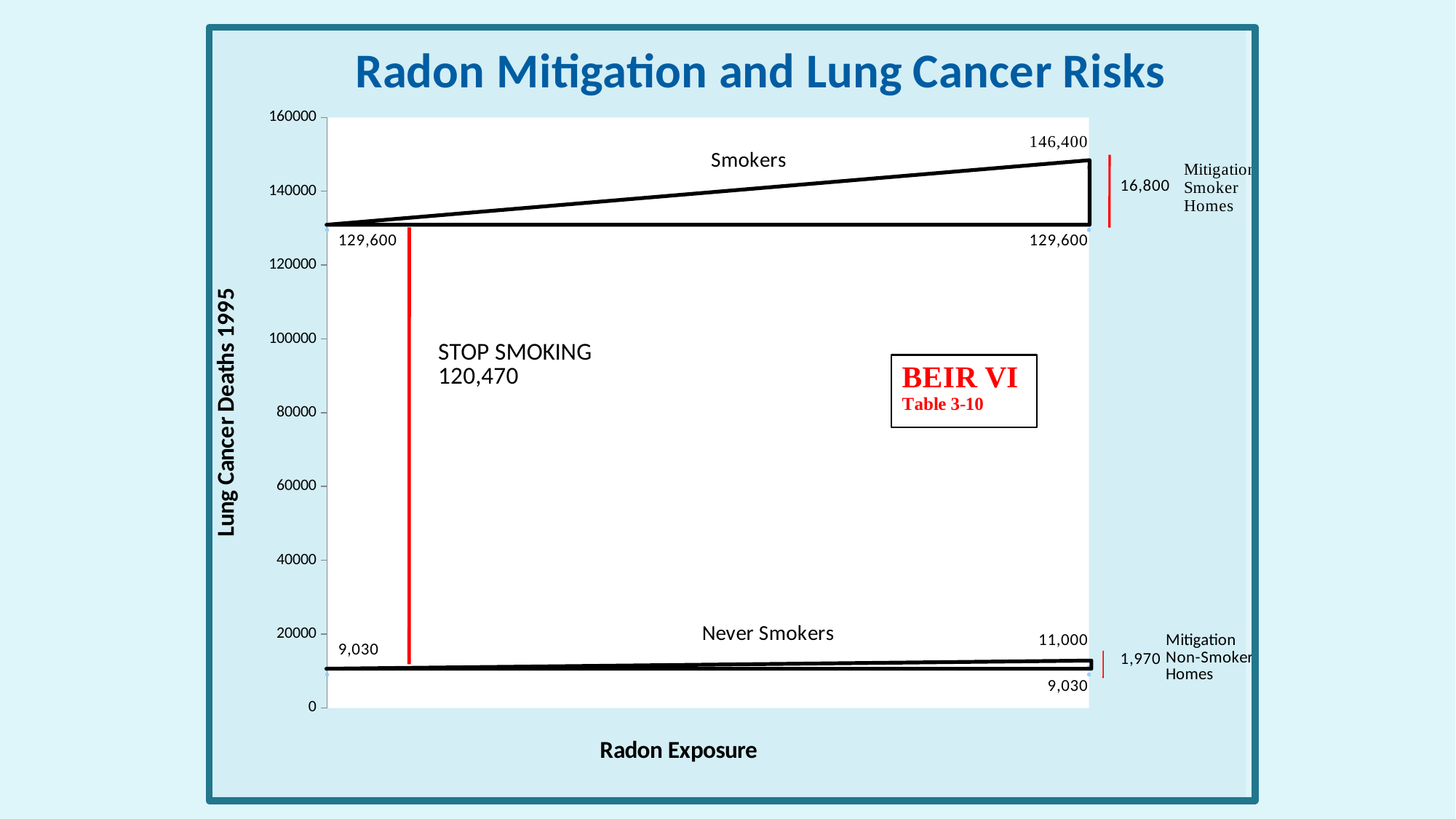
Does the Smokers line rise or fall as radon exposure increases along the x axis? rise What is the highest value labelled on the Smokers line at the right end of the chart? 146,400 What is the value labelled at the left end of the Smokers line? 129,600 Which group has the higher lung cancer deaths, Smokers or Never Smokers? Smokers Is the value at the right end of the Never Smokers line (11,000) greater or less than 20000? less What is the highest value labelled on the Never Smokers line at the right end of the chart? 11,000 What is the difference between the Smokers value of 146,400 and the Never Smokers value of 11,000 at the right end of the chart? 135,400 What is the y-axis label of the chart? Lung Cancer Deaths 1995 What is the value labelled at the left end of the Never Smokers line? 9,030 What reduction in lung cancer deaths is labelled for mitigation of smoker homes? 16,800 What is the title of the chart? Radon Mitigation and Lung Cancer Risks What reduction in lung cancer deaths is labelled for mitigation of non-smoker homes? 1,970